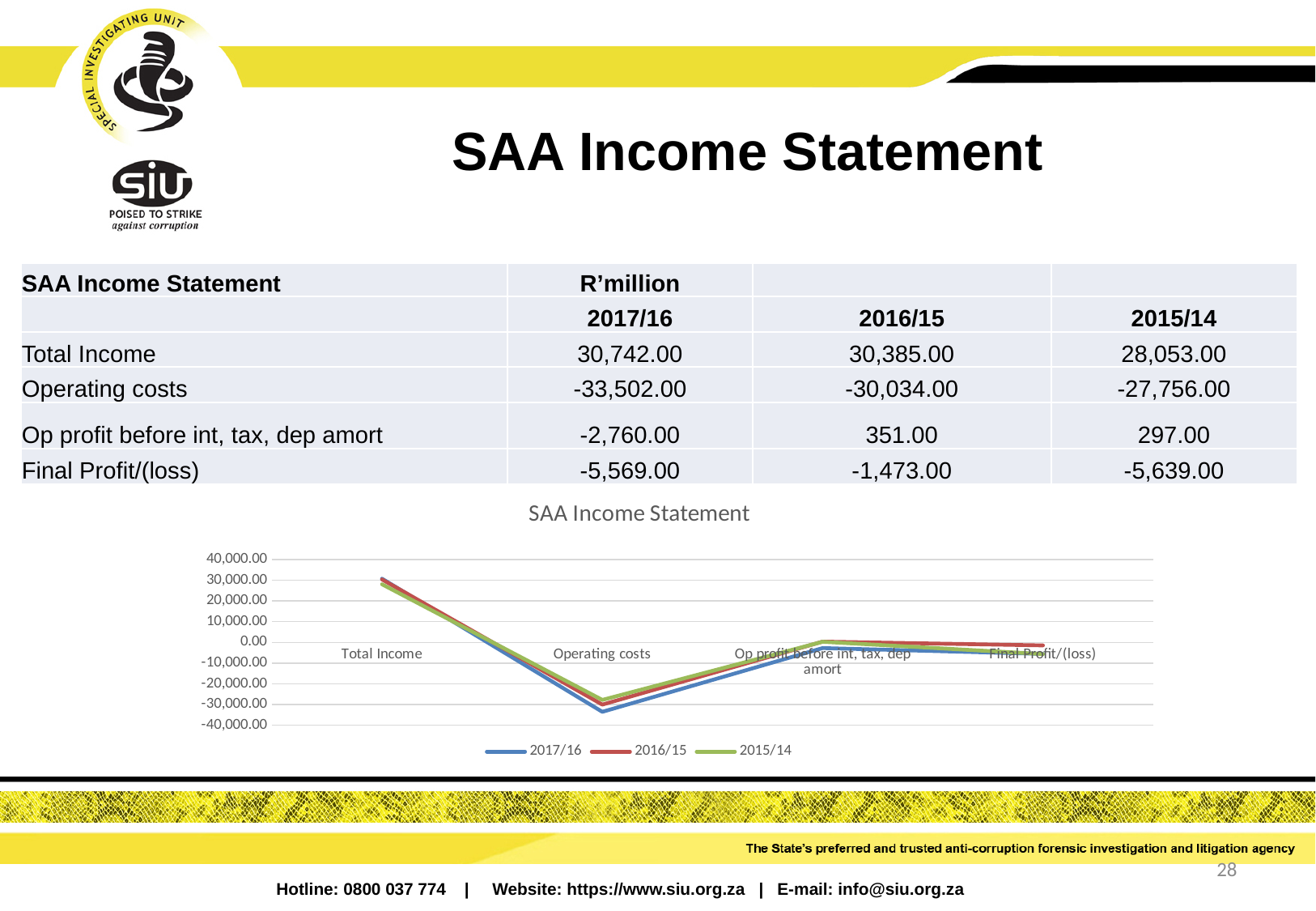
Which category has the highest value for the 2017/16 series? Total Income Is the Operating costs value for 2017/16 greater or less than -30,000.00? less What is the Operating costs value for 2015/14? -27,756.00 What is the Total Income value for 2017/16? 30,742.00 Which year has the larger Total Income, 2017/16 or 2015/14? 2017/16 How many categories are plotted along the x axis of the chart? 4 What is the title of the chart? SAA Income Statement How many series does the chart legend list? 3 What is the difference between Total Income in 2017/16 and in 2016/15? 357.00 What is the Final Profit/(loss) value for 2016/15? -1,473.00 Which category has the lowest value for the 2017/16 series? Operating costs What kind of chart is shown on the slide? line chart